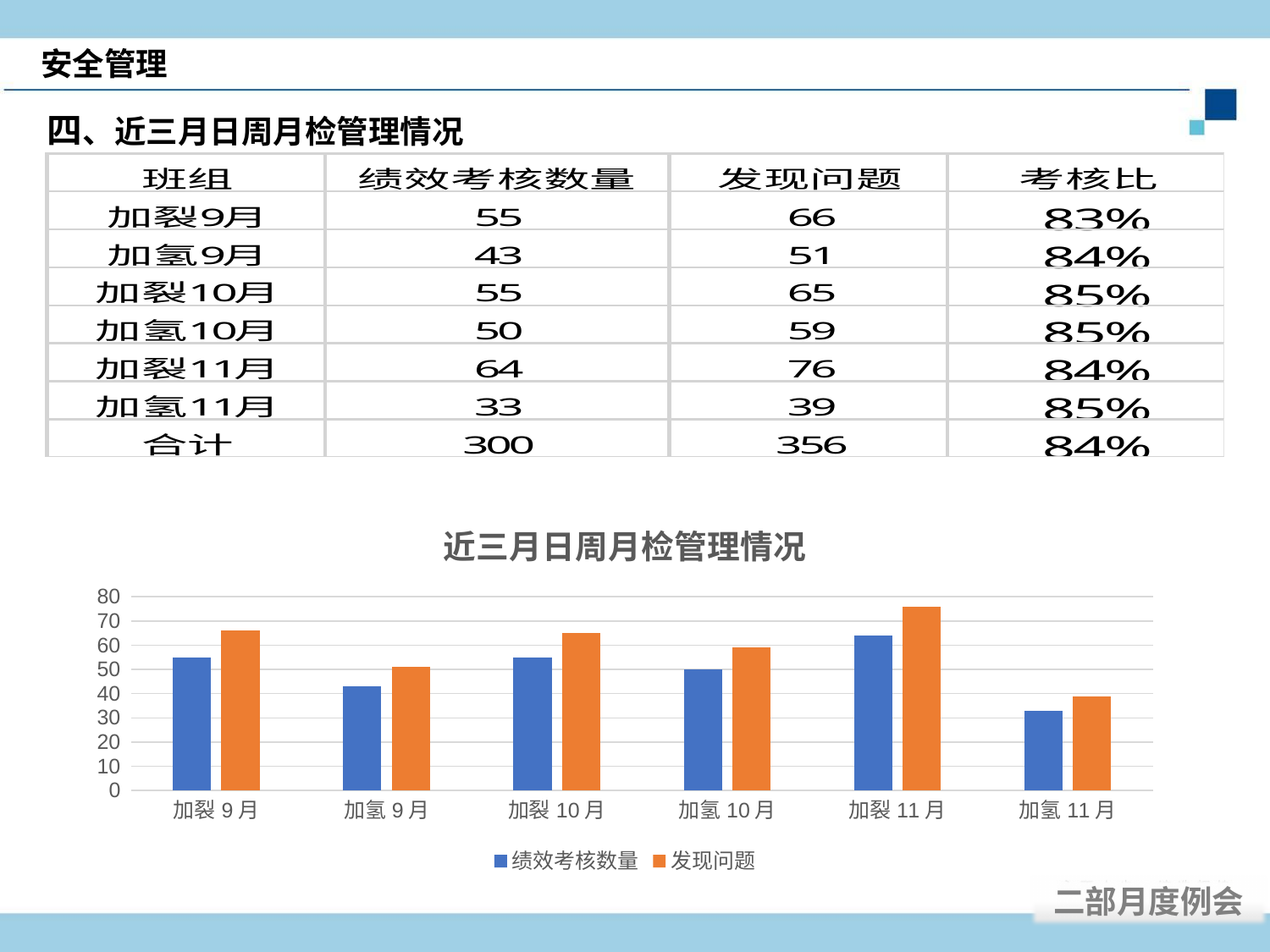
Which is larger, the 绩效考核数量 for 加裂10月 or for 加氢10月? 加裂10月 What kind of chart is shown on the slide? bar chart Is the 发现问题 value for 加氢11月 greater or less than 40? less What is the difference between 发现问题 and 绩效考核数量 for 加裂9月? 11 Which category has the lowest 绩效考核数量 value? 加氢11月 How many categories are shown on the x axis of the chart? 6 Is the 发现问题 value for 加裂11月 greater or less than 70? greater What is the title of the chart? 近三月日周月检管理情况 What is the 绩效考核数量 value for 加裂11月? 64 Which category has the highest 发现问题 value? 加裂11月 How many series does the chart legend list? 2 What is the 发现问题 value for 加氢10月? 59